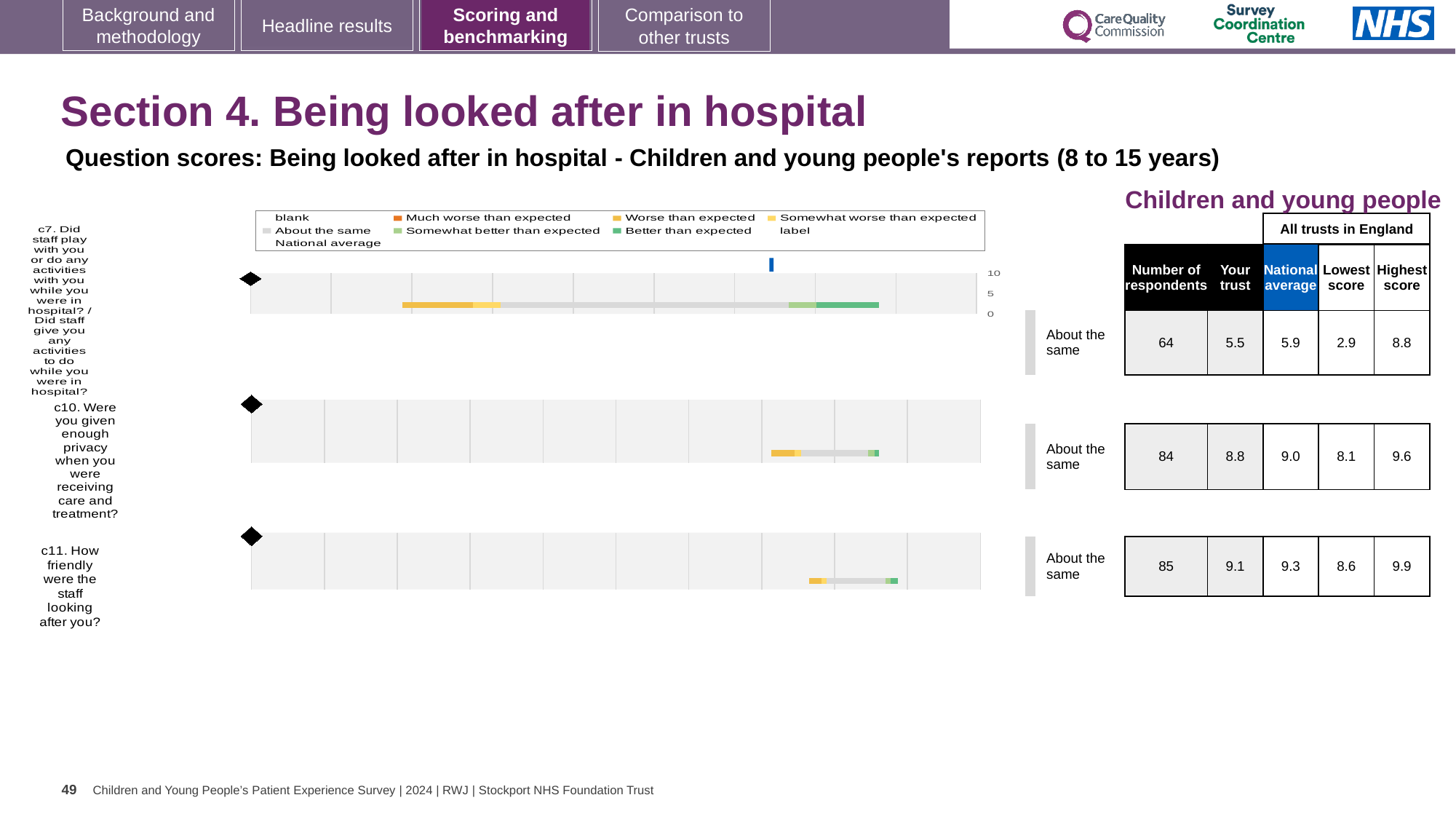
What is the national average score for c11 (How friendly were the staff looking after you?)? 9.3 Which question has the lowest number of respondents? c7. Did staff play with you or do any activities with you while you were in hospital? For c7, which is larger: the 'Your trust' score or the national average? National average Which question has the highest 'Your trust' score? c11. How friendly were the staff looking after you? How many respondents answered c7 (Did staff play with you or do any activities with you while you were in hospital?)? 64 What benchmark category is shown for c10? About the same How many questions are plotted on this slide? 3 What is the lowest score among all trusts in England for c10? 8.1 What is the difference between the highest score and the lowest score for c11? 1.3 What is the 'Your trust' score for c10 (Were you given enough privacy when you were receiving care and treatment?)? 8.8 What kind of chart is used to show the question scores on this slide? bar chart By how much does the national average exceed the 'Your trust' score for c10? 0.2